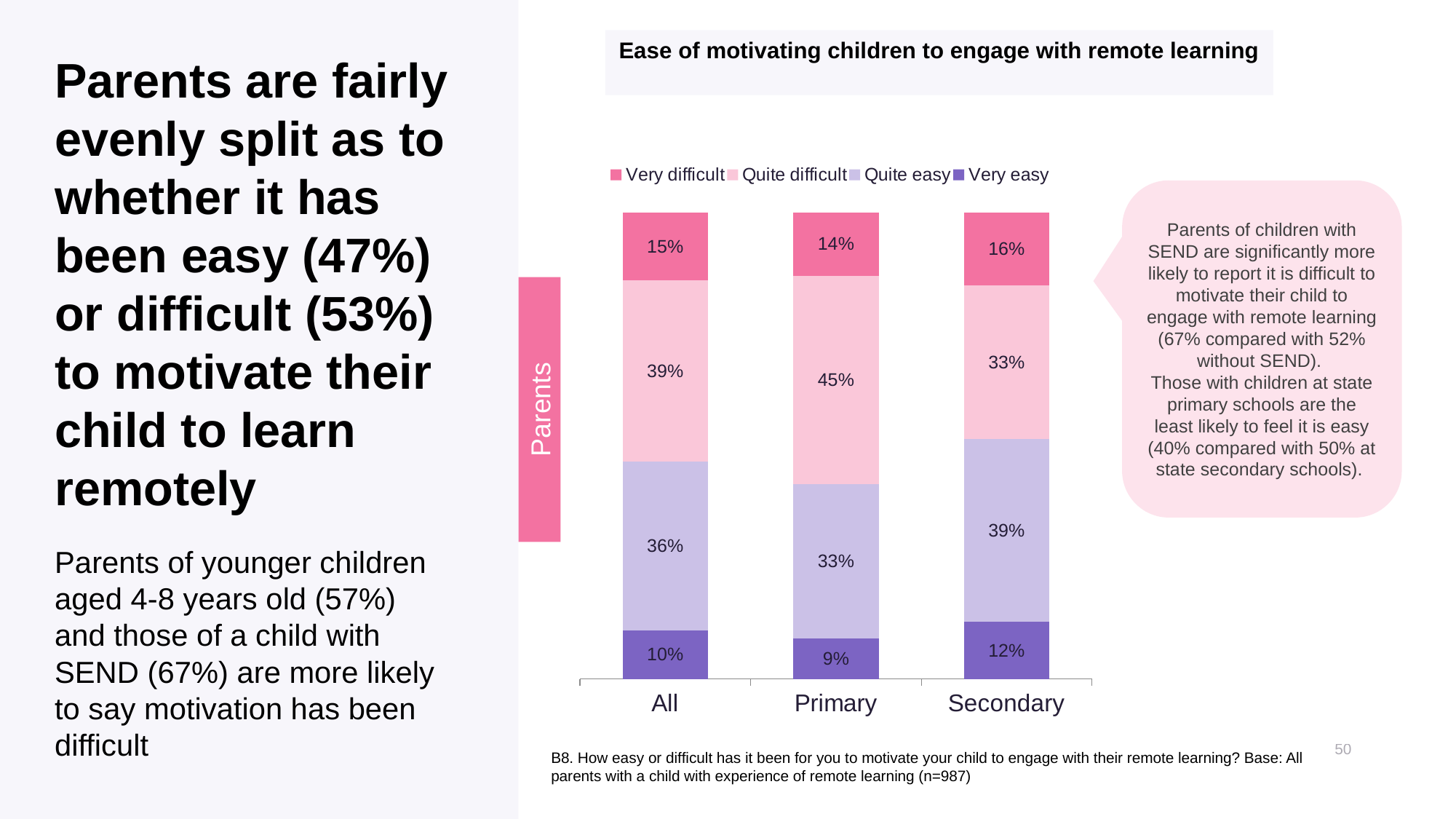
Which category has the lowest 'Very easy' value? Primary How many categories are shown on the x axis? 3 What kind of chart is shown? Stacked bar chart What is the 'Very easy' value for Secondary? 12% What is the 'Quite difficult' value for Primary? 45% How many series does the legend list? 4 What is the difference between the 'Quite difficult' values for Primary and Secondary? 12 percentage points What is the title of the chart? Ease of motivating children to engage with remote learning Is the 'Very difficult' value larger for Primary or Secondary? Secondary Which category has the highest 'Quite easy' value? Secondary What is the 'Quite easy' value for Primary? 33% What percentage of parents in the 'All' category said it was very difficult to motivate their child? 15%